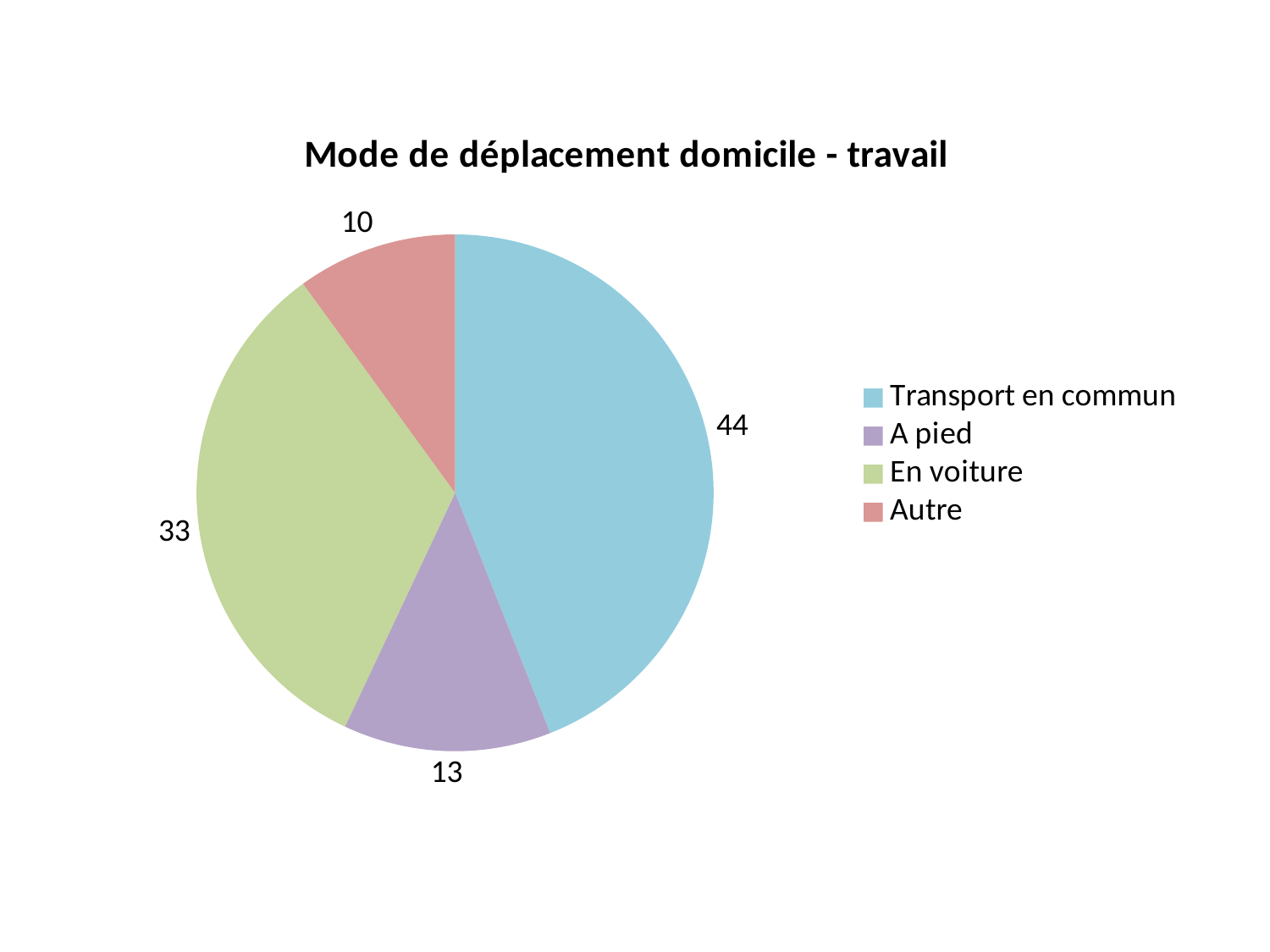
What is the value for Autre? 10 What share of the pie does the En voiture slice represent? 33% Which category has the smallest slice? Autre What is the value for En voiture? 33 Which category has the largest slice? Transport en commun Which is larger, the value for A pied or the value for Autre? A pied What kind of chart is shown on the slide? Pie chart What is the difference between the values for Transport en commun and En voiture? 11 What is the title of the chart? Mode de déplacement domicile - travail What is the value for A pied? 13 What is the value for Transport en commun? 44 How many categories does the pie chart show? 4